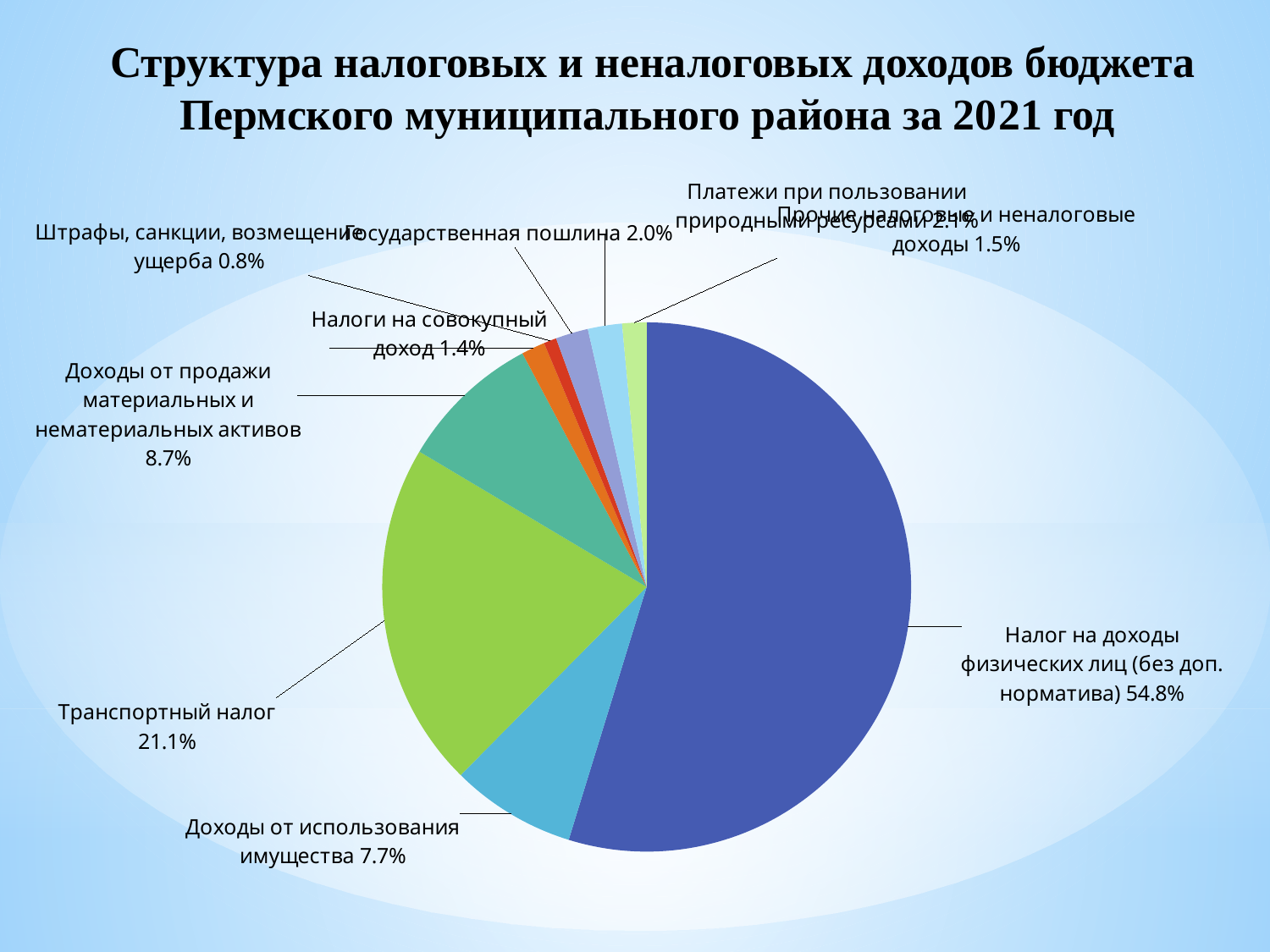
What is the difference in percentage points between Налог на доходы физических лиц (без доп. норматива) and Транспортный налог? 33.7 Which category has the largest share of the pie? Налог на доходы физических лиц (без доп. норматива) How many slices does the pie chart have? 9 What year does the slide title say the budget revenue structure is for? 2021 What share of the pie does Транспортный налог have? 21.1% What share of the pie does Прочие налоговые и неналоговые доходы have? 1.5% Which is larger: the share for Доходы от продажи материальных и нематериальных активов or the share for Доходы от использования имущества? Доходы от продажи материальных и нематериальных активов What kind of chart is shown on the slide? pie chart What share of the pie does Доходы от продажи материальных и нематериальных активов have? 8.7% What share of the pie does Доходы от использования имущества have? 7.7% What share of the pie does Государственная пошлина have? 2.0% Which category has the smallest share of the pie? Штрафы, санкции, возмещение ущерба